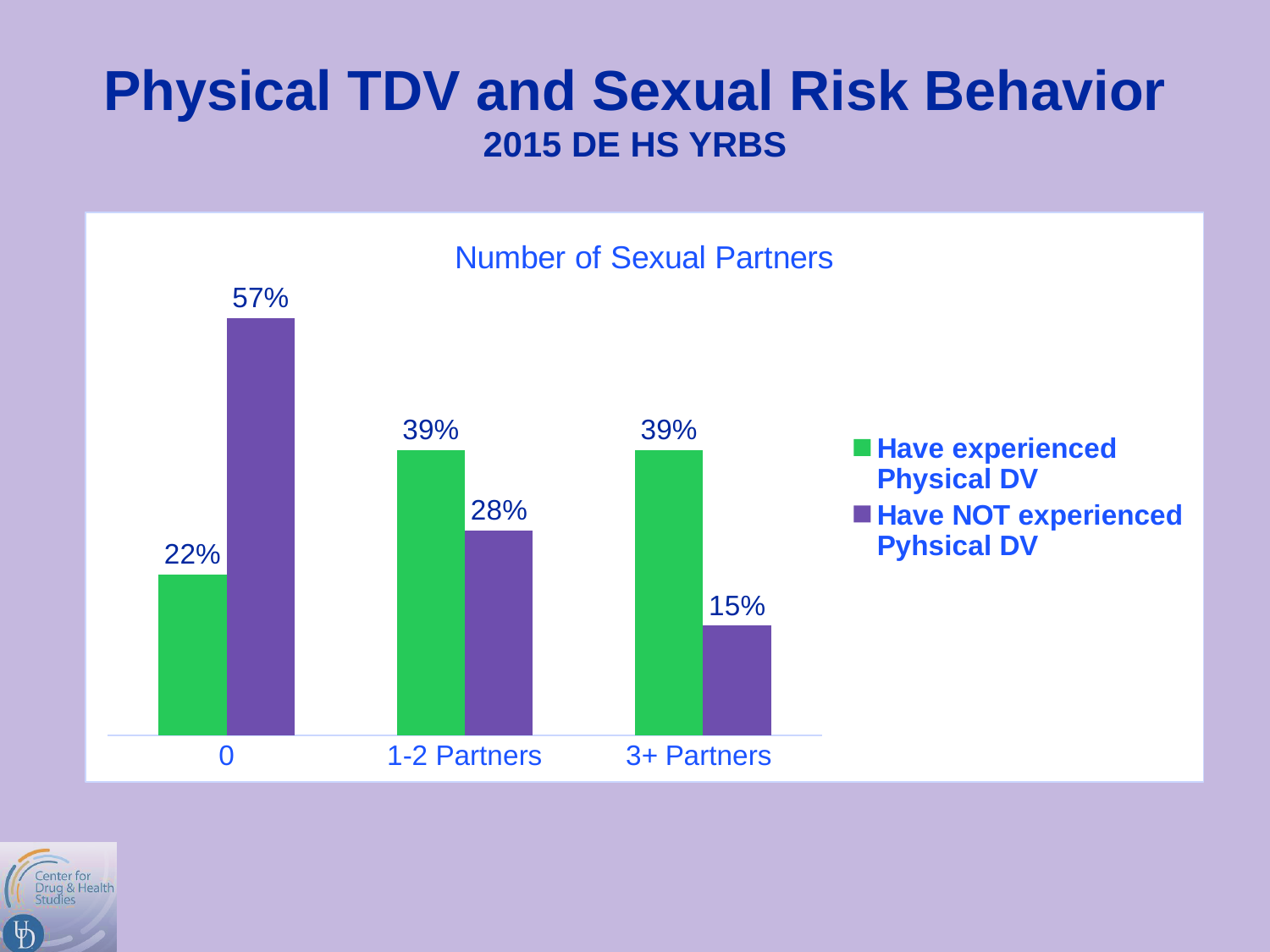
Which category has the highest value for 'Have NOT experienced Pyhsical DV'? 0 How many categories are shown on the x axis? 3 What is the value for 'Have experienced Physical DV' in the 1-2 Partners category? 39% Which category has the lowest value for 'Have experienced Physical DV'? 0 How many series does the legend list? 2 In the 1-2 Partners category, which series has the larger value? Have experienced Physical DV What kind of chart is shown on the slide? Bar chart What is the difference between the two series in the 3+ Partners category? 24% What is the value for 'Have NOT experienced Pyhsical DV' in the 3+ Partners category? 15% What is the value for 'Have experienced Physical DV' in the 0 partners category? 22% What is the value for 'Have NOT experienced Pyhsical DV' in the 0 partners category? 57% What is the title of the chart? Number of Sexual Partners